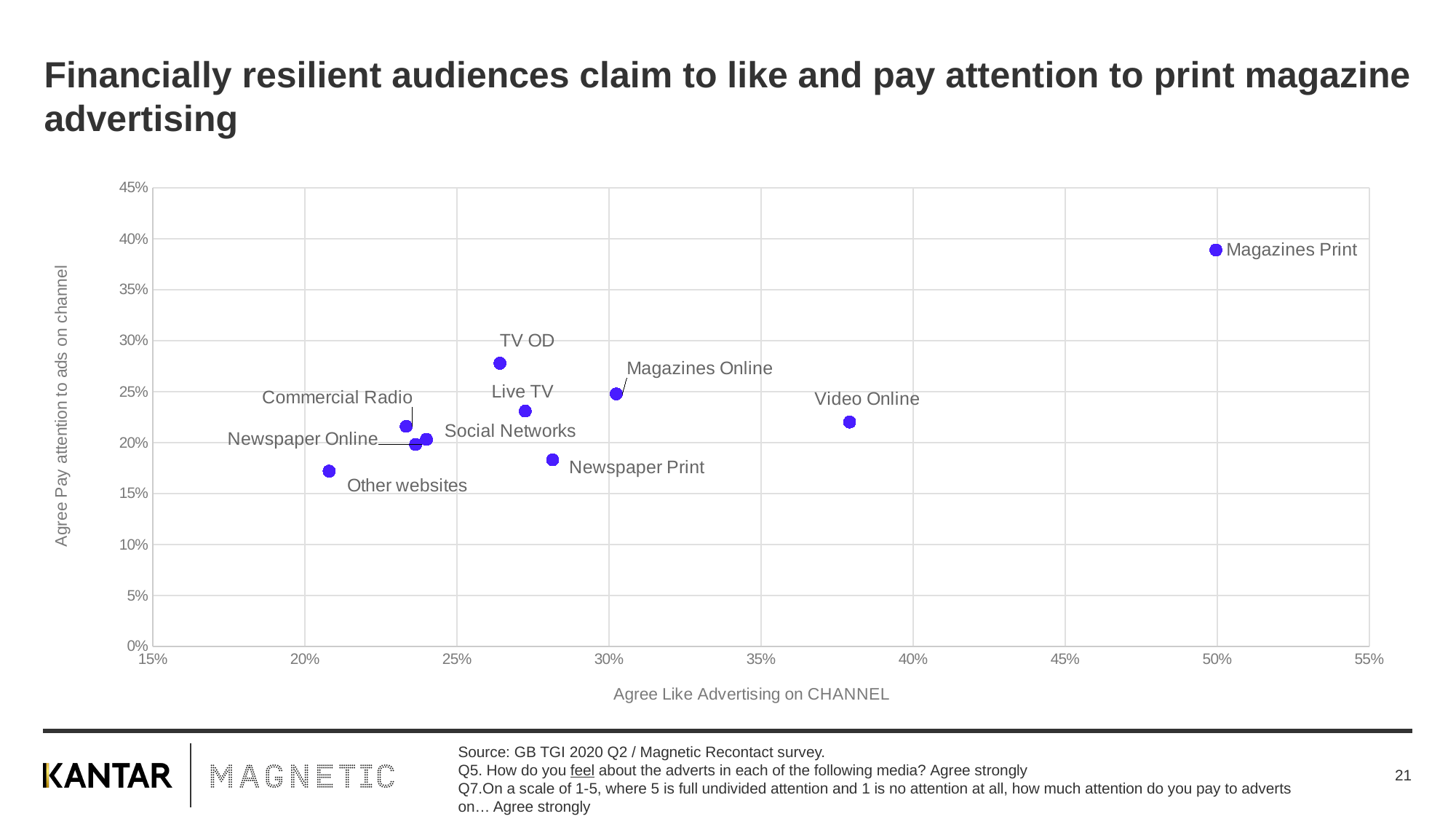
Is the 'Agree Pay attention to ads on channel' value for TV OD greater or less than 25%? greater Is the 'Agree Pay attention to ads on channel' value for Magazines Print greater or less than 35%? greater What is the title of the horizontal axis of the chart? Agree Like Advertising on CHANNEL Which channel has the lowest value for 'Agree Like Advertising on CHANNEL'? Other websites What kind of chart is shown on the slide? Scatter chart Which channel has the highest value for 'Agree Pay attention to ads on channel'? Magazines Print How many channels are plotted as points on the chart? 10 Is the 'Agree Like Advertising on CHANNEL' value for Video Online greater or less than 35%? greater Which channel has the highest value for 'Agree Like Advertising on CHANNEL'? Magazines Print Which has a higher 'Agree Pay attention to ads on channel' value, TV OD or Live TV? TV OD Which channel has the lowest value for 'Agree Pay attention to ads on channel'? Other websites Which has a higher 'Agree Like Advertising on CHANNEL' value, Newspaper Print or Video Online? Video Online